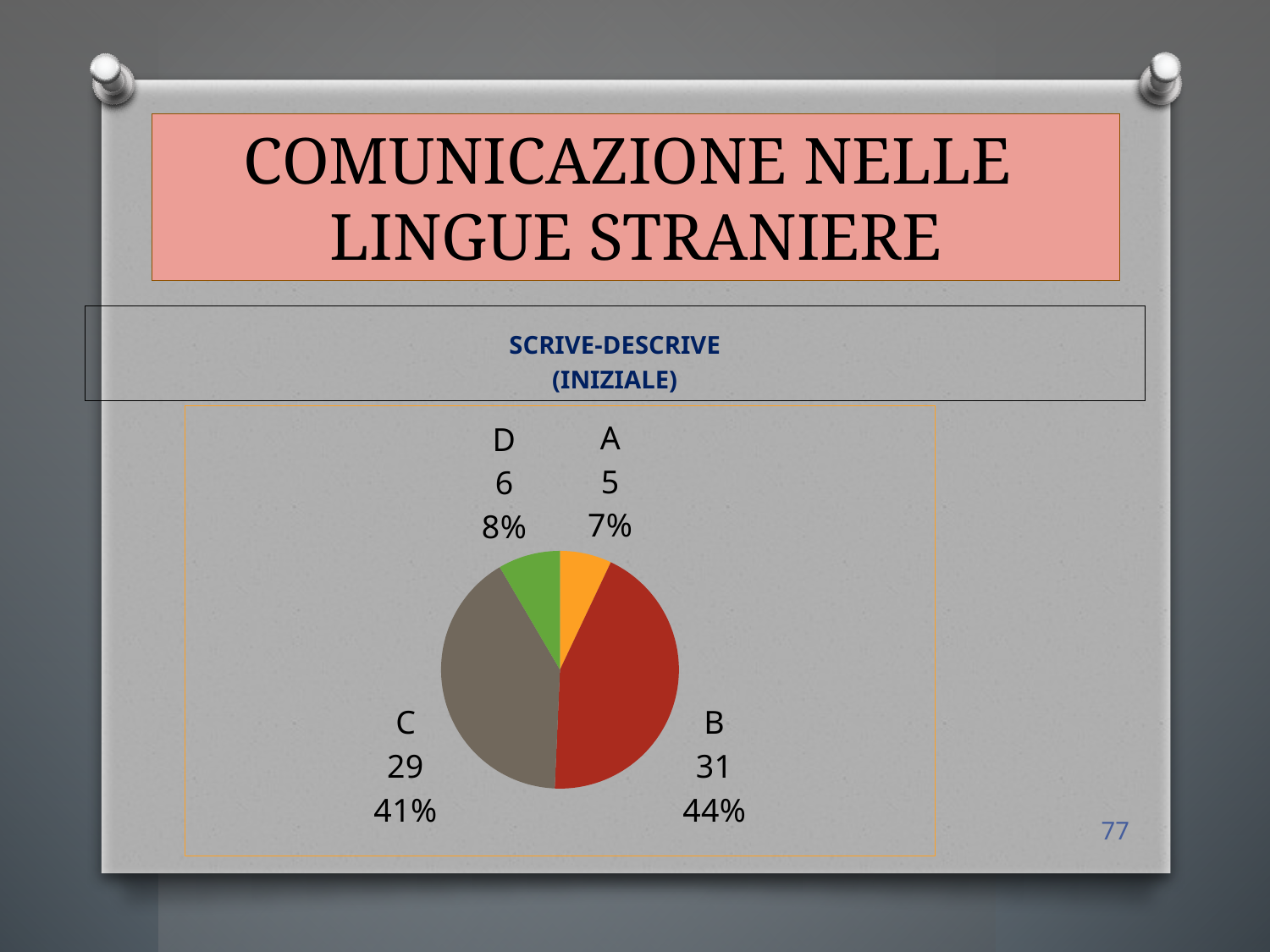
Which category has the smallest slice? A What is the value for category A? 5 Which category has the largest slice? B What colour is the slice for category C? grey Which is larger, the value for D or the value for A? D What percentage share does category D have? 8% What is the difference between the values for B and C? 2 What is the title of the chart? SCRIVE-DESCRIVE (INIZIALE) What is the value for category B? 31 How many slices does the pie chart have? 4 What kind of chart is shown on the slide? pie chart What percentage share does category C have? 41%